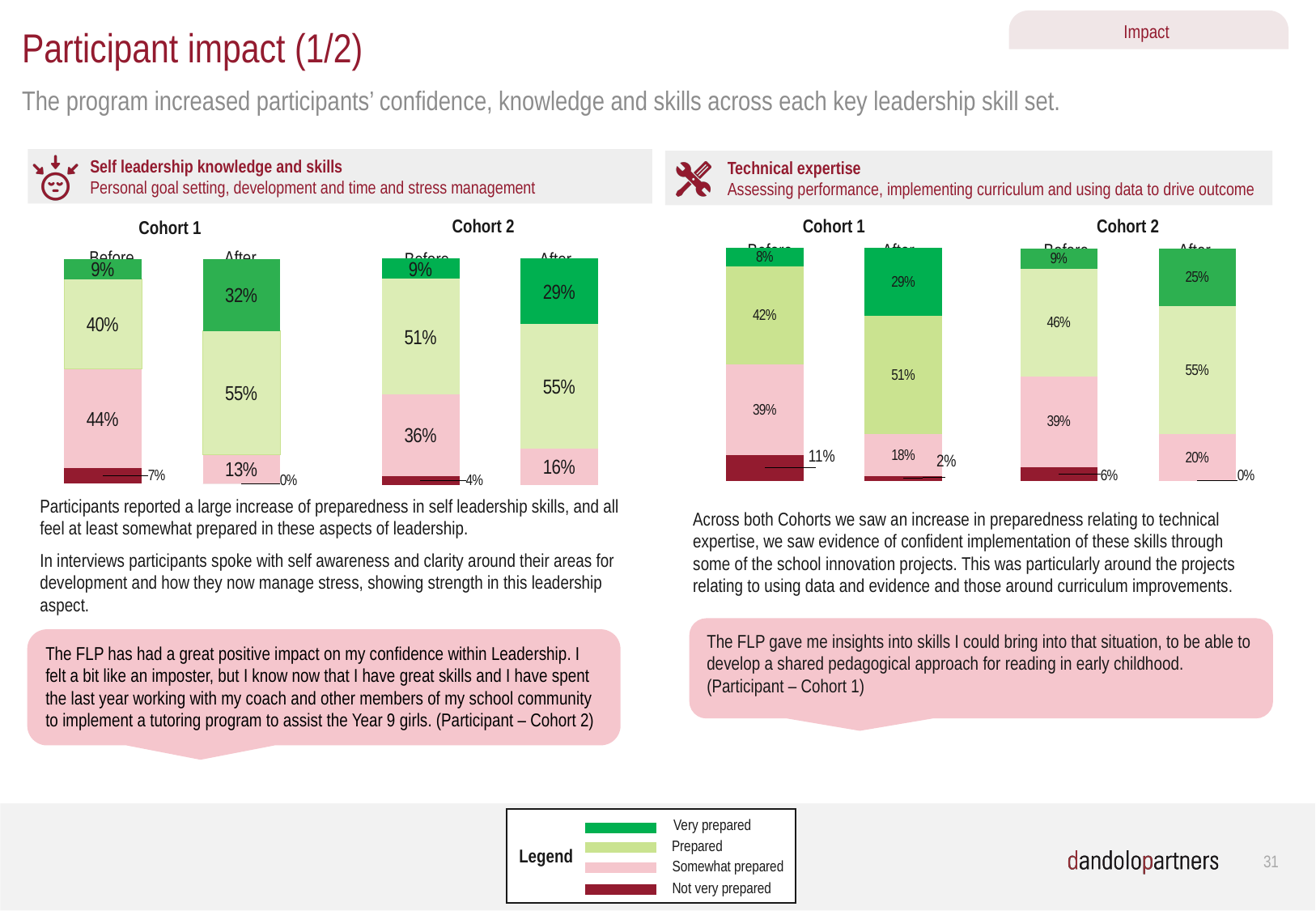
In the Technical expertise Cohort 2 chart, which segment of the 'Before' bar is the smallest? Not very prepared In the Self leadership knowledge and skills Cohort 1 chart, which segment of the 'After' bar is the largest? Prepared In the Self leadership knowledge and skills Cohort 2 chart, what percentage of participants were 'Prepared' before the program? 51% In the Technical expertise Cohort 1 chart, what is the difference between the 'Prepared' share after the program and before the program? 9% In the Self leadership knowledge and skills Cohort 1 chart, what percentage of participants were 'Somewhat prepared' before the program? 44% How many series does the legend at the bottom of the slide list? 4 In the Technical expertise Cohort 1 chart, what percentage of participants were 'Not very prepared' before the program? 11% Which colour represents 'Very prepared' in the legend? Dark green What type of chart is used to show the Cohort 1 and Cohort 2 results on this slide? Stacked bar chart In the Self leadership knowledge and skills Cohort 1 chart, what percentage of participants were 'Very prepared' after the program? 32% In the Self leadership knowledge and skills Cohort 2 chart, which is larger: the 'Somewhat prepared' share before the program or after the program? Before In the Technical expertise Cohort 2 chart, what percentage of participants were 'Very prepared' after the program? 25%